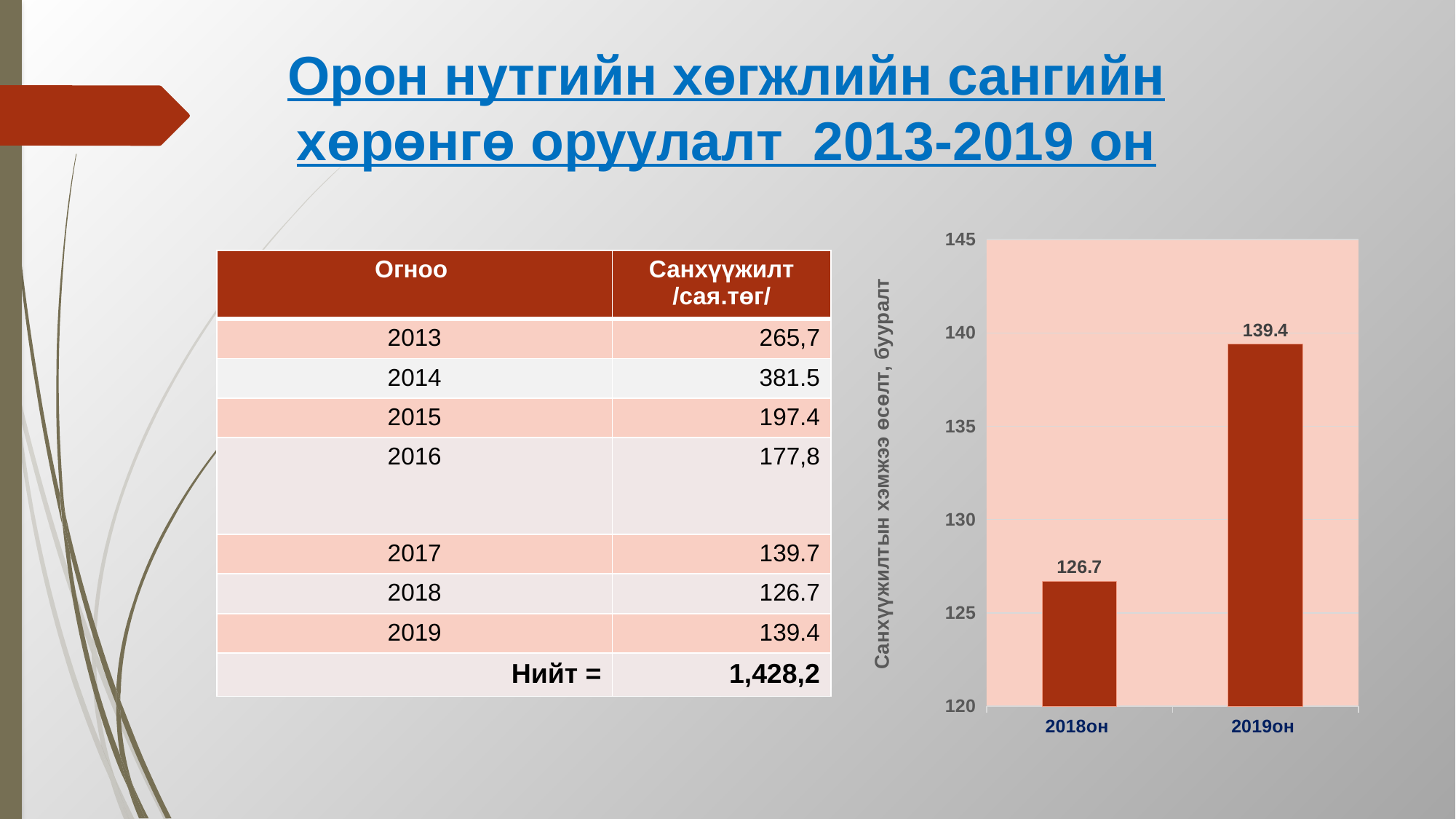
What is the value for 2018он in the bar chart? 126.7 What is the value for 2019он in the bar chart? 139.4 How many categories are shown in the bar chart? 2 Do the values in the bar chart rise or fall from 2018он to 2019он? rise Which is larger in the bar chart, the value for 2018он or 2019он? 2019он What is the difference between the values for 2019он and 2018он in the bar chart? 12.7 What kind of chart is shown on the right of the slide? bar chart Which category has the lowest value in the bar chart? 2018он Is the value for 2019он in the bar chart greater or less than 135? greater What is the label on the vertical axis of the bar chart? Санхүүжилтын хэмжээ өсөлт, бууралт Is the value for 2018он in the bar chart greater or less than 130? less Which category has the highest value in the bar chart? 2019он